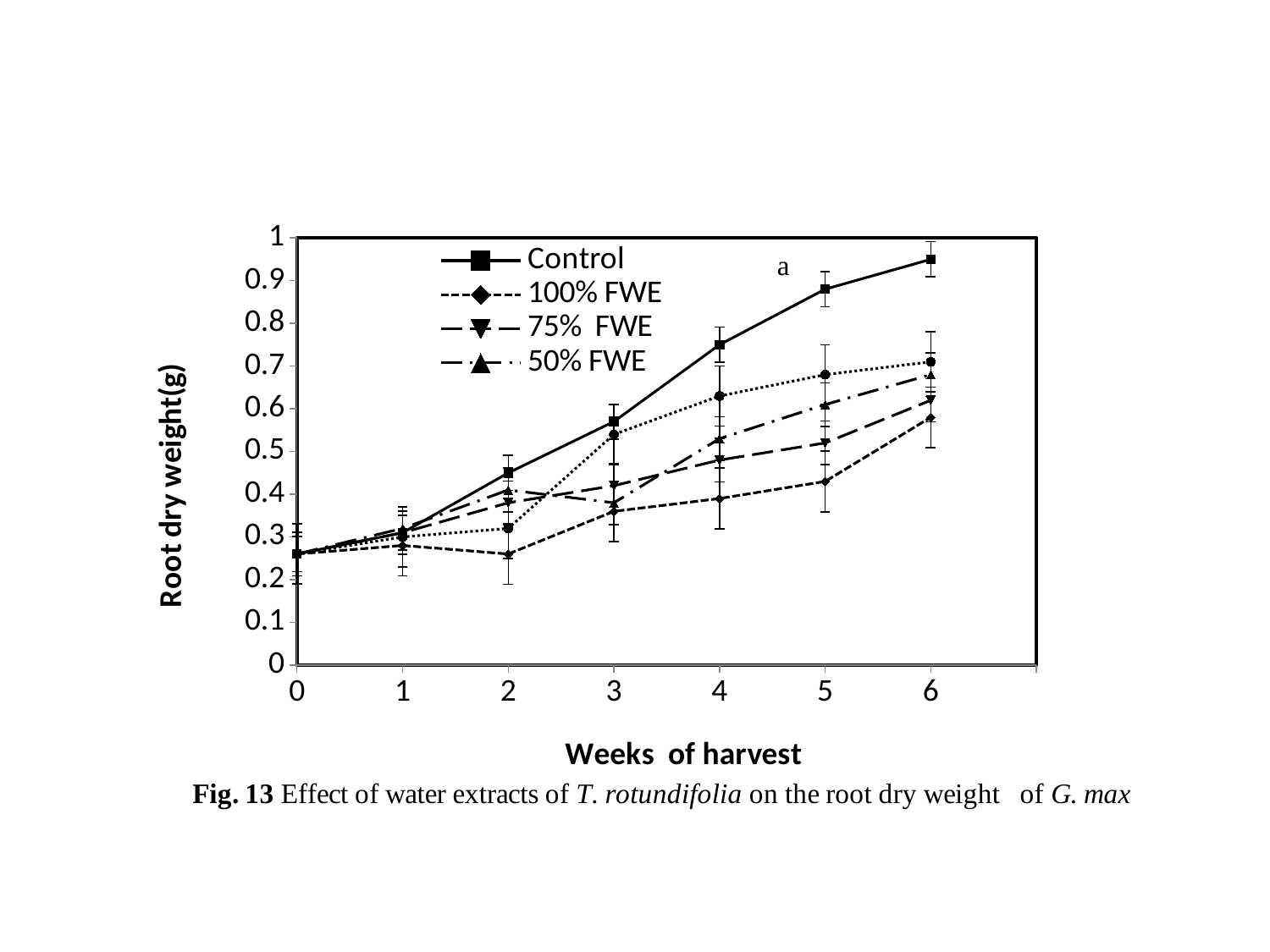
How many series does the legend list? 4 Is the Control value at week 6 greater or less than 0.9? greater Which series has the highest root dry weight at week 6? Control Is the 100% FWE value at week 2 greater or less than 0.3? less How many week values are marked along the x axis? 7 Does the Control series rise or fall from week 0 to week 6? rise Is the Control value at week 4 greater or less than 0.7? greater Which series has the lowest root dry weight at week 5? 100% FWE At week 4, which is larger: the Control value or the 100% FWE value? Control What kind of chart is shown on the slide? line chart